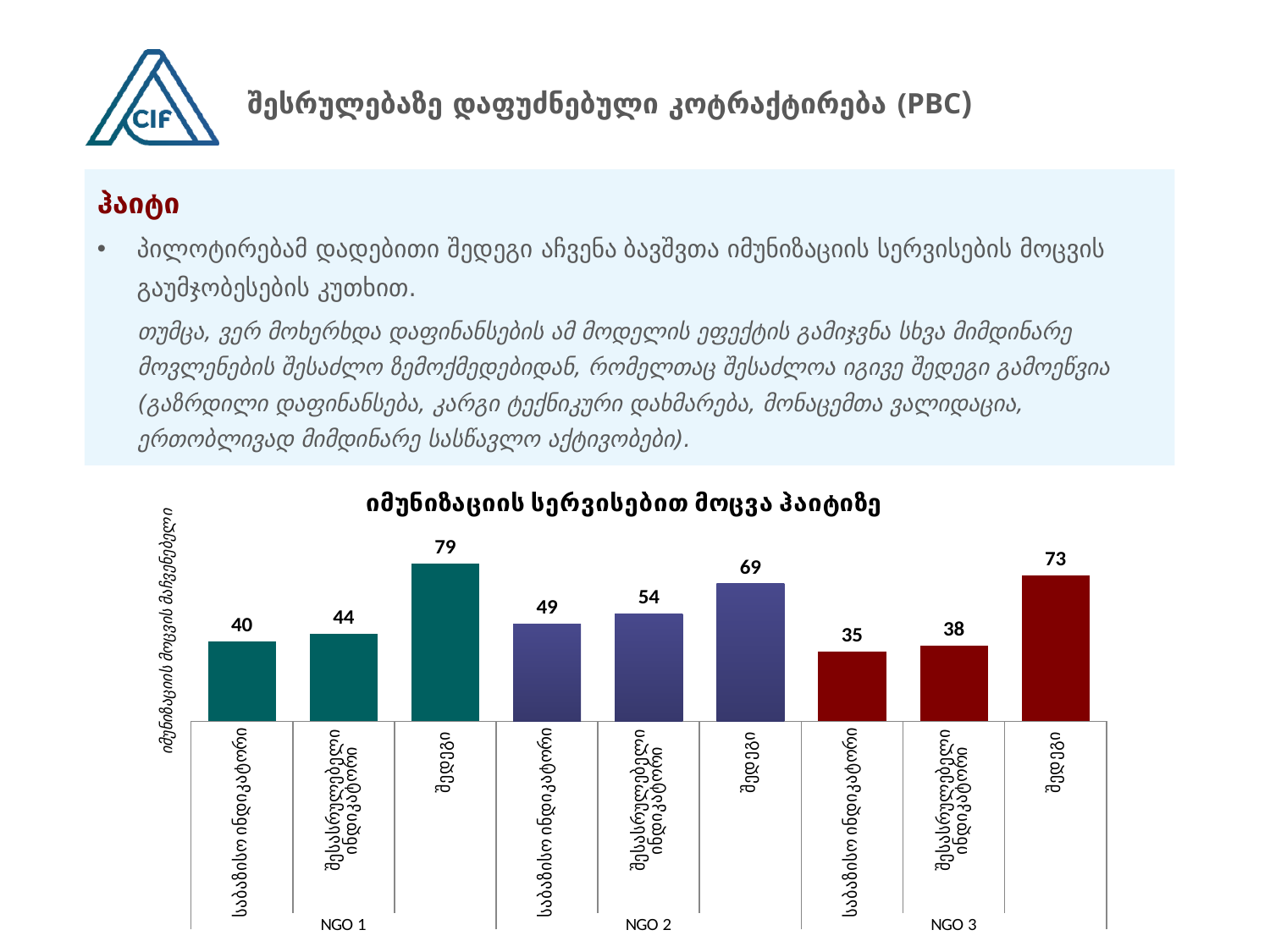
How many NGO groups are shown on the x axis of the chart? 3 How many bars are plotted in the chart? 9 What is the difference between the შედეგი value for NGO 1 and the შედეგი value for NGO 2? 10 What type of chart is shown on the slide? bar chart Which is larger: the შედეგი value for NGO 2 or the შედეგი value for NGO 3? NGO 3 (73) What is the value of the შედეგი bar for NGO 1? 79 Which bar has the highest value in the chart? შედეგი for NGO 1 (79) What is the title of the chart? იმუნიზაციის სერვისებით მოცვა ჰაიტიზე Which bar has the lowest value in the chart? საბაზისო ინდიკატორი for NGO 3 (35) What is the value of the საბაზისო ინდიკატორი bar for NGO 3? 35